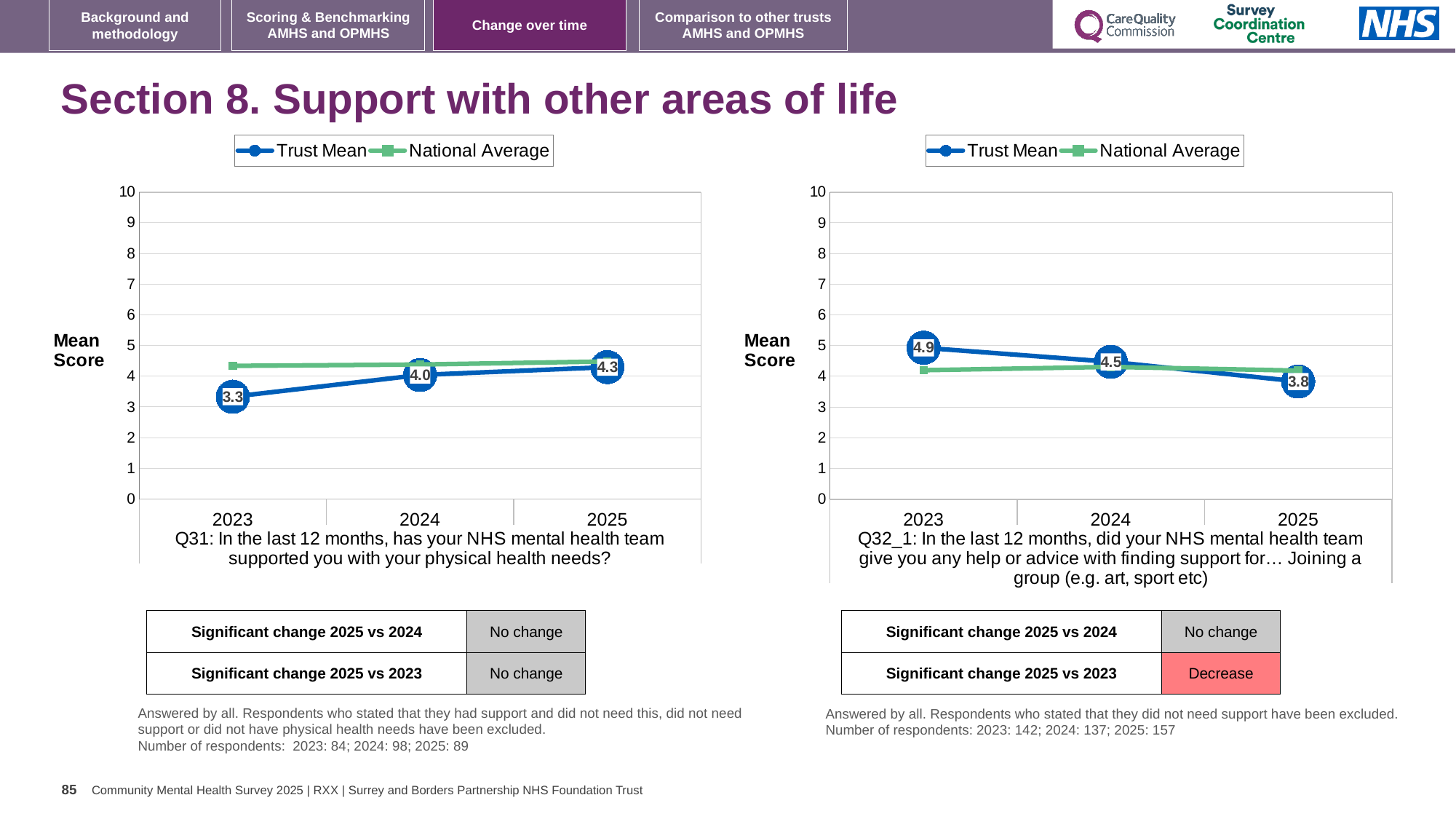
In the right chart (Q32_1), does the Trust Mean rise or fall from 2023 to 2025? fall In the left chart (Q31), which year has the lowest Trust Mean? 2023 In the left chart (Q31), does the Trust Mean rise or fall from 2023 to 2025? rise In the left chart (Q31), is the Trust Mean for 2023 greater or less than the National Average for 2023? less In the left chart (Q31), what is the Trust Mean for 2023? 3.3 In the right chart (Q32_1), what is the Trust Mean for 2023? 4.9 How many series does the legend of the right chart (Q32_1) list? 2 In the right chart (Q32_1), which year has the highest Trust Mean? 2023 In the left chart (Q31), what is the Trust Mean for 2025? 4.3 In the right chart (Q32_1), what is the Trust Mean for 2025? 3.8 In the left chart (Q31), by how much did the Trust Mean increase from 2023 to 2025? 1.0 In the right chart (Q32_1), what is the difference between the Trust Mean in 2023 and in 2025? 1.1